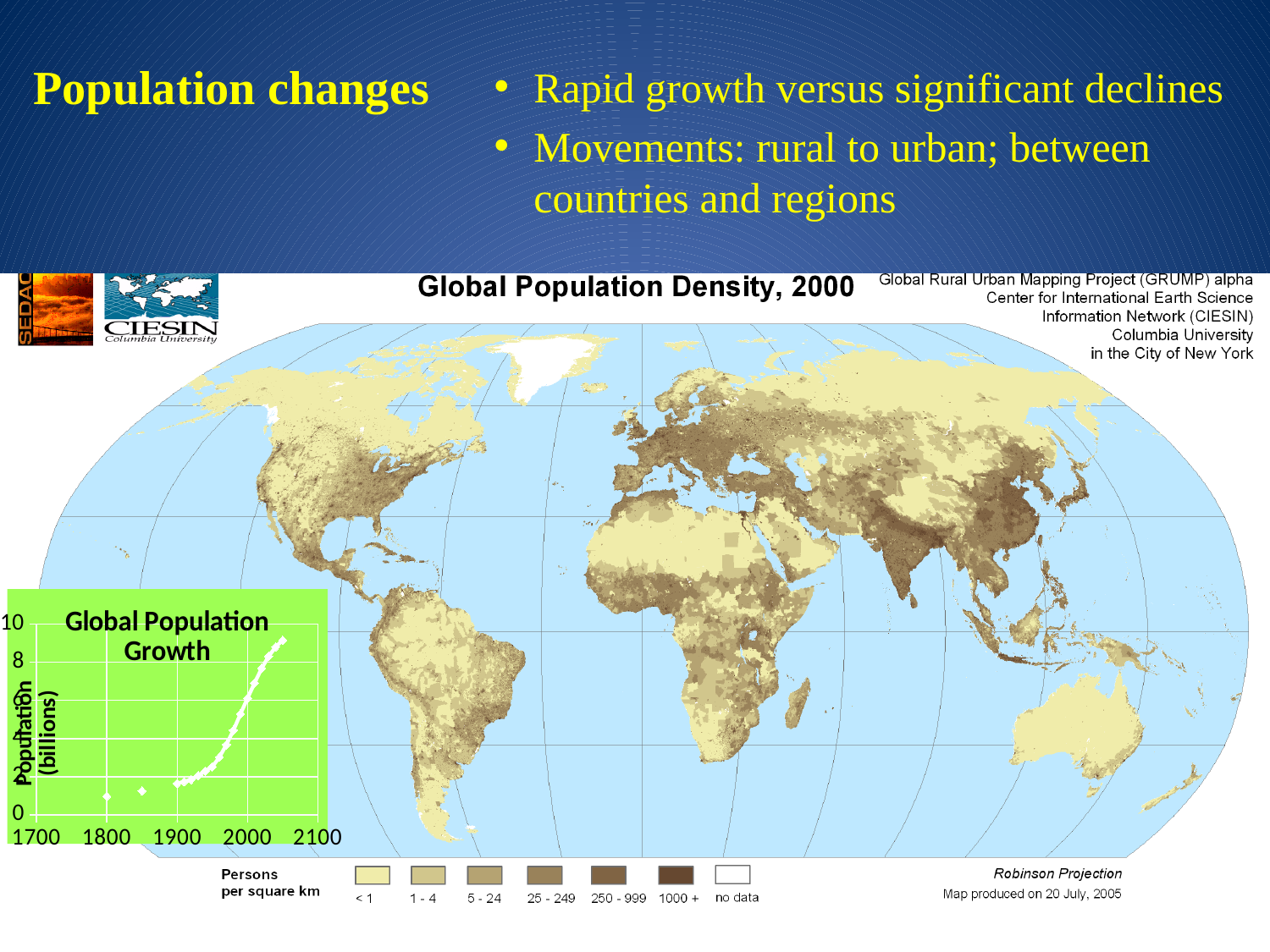
In the 'Global Population Growth' chart, is the value for the year 2000 greater or less than 8? less In the 'Global Population Growth' chart, do the values rise or fall as the year increases along the x axis? rise What kind of chart is the 'Global Population Growth' chart in the lower left of the slide? line chart In the 'Global Population Growth' chart, is the value for the year 1900 greater or less than 8? less What is the title of the chart in the lower left of the slide? Global Population Growth In the 'Global Population Growth' chart, which year has the larger population value, 1900 or 2000? 2000 What is the y-axis label of the 'Global Population Growth' chart? Population (billions) In the 'Global Population Growth' chart, is the value for the last plotted point (around 2050) greater or less than 8? greater